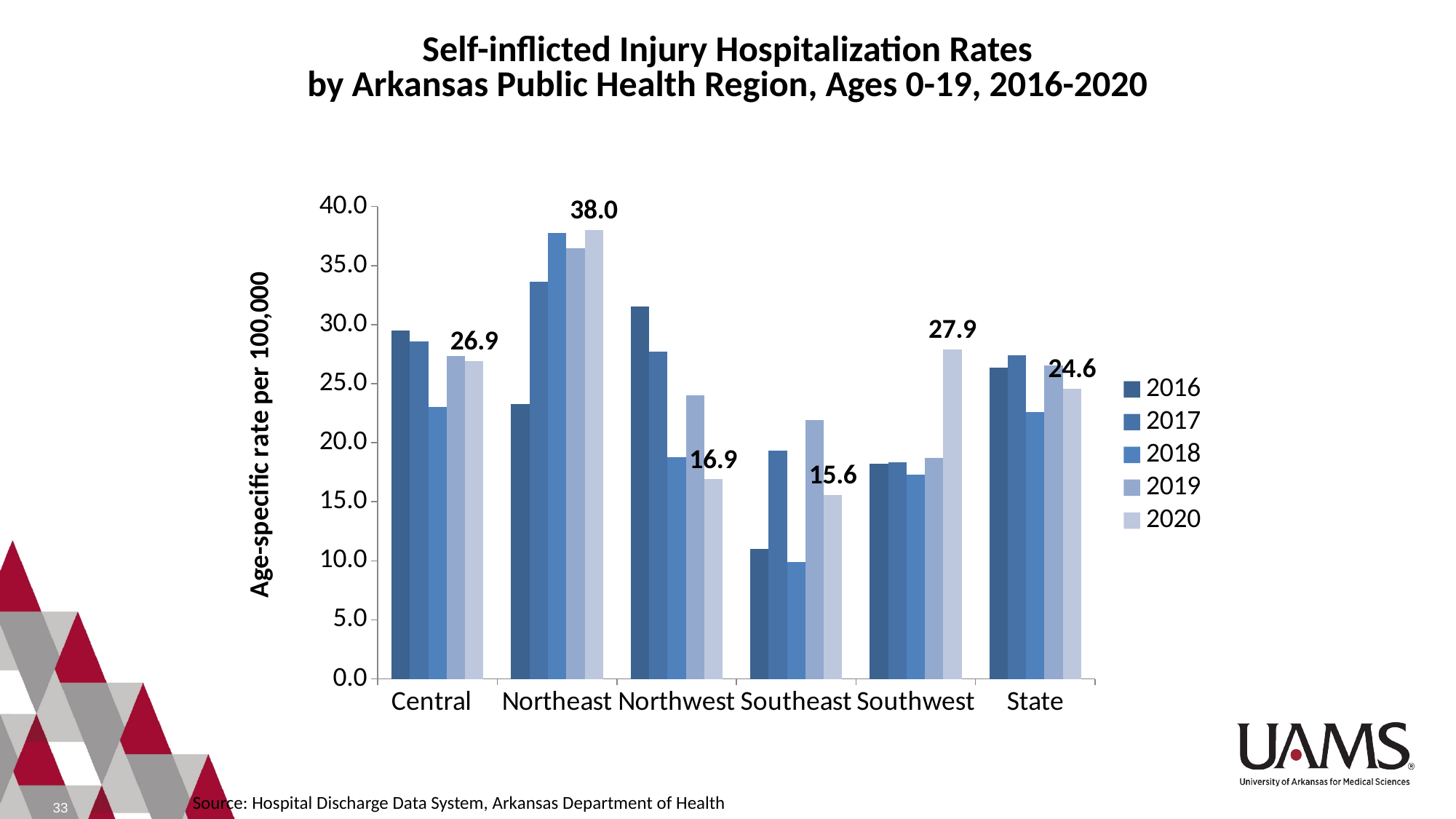
Which region has the lowest 2020 rate? Southeast What is the 2020 rate for the State? 24.6 How many regions (categories) are shown on the x axis? 6 How many years does the legend list? 5 Is the 2017 value for Northeast greater or less than 35.0? less What is the 2020 rate for the Northeast region? 38.0 Is the 2016 value for Southeast greater or less than 15.0? less Which has the larger 2020 rate, Southwest or State? Southwest What kind of chart is shown on the slide? Bar chart What is the 2020 self-inflicted injury hospitalization rate for the Central region? 26.9 What is the difference between the 2020 rates for Northeast and Southeast? 22.4 Which region has the highest 2020 rate? Northeast